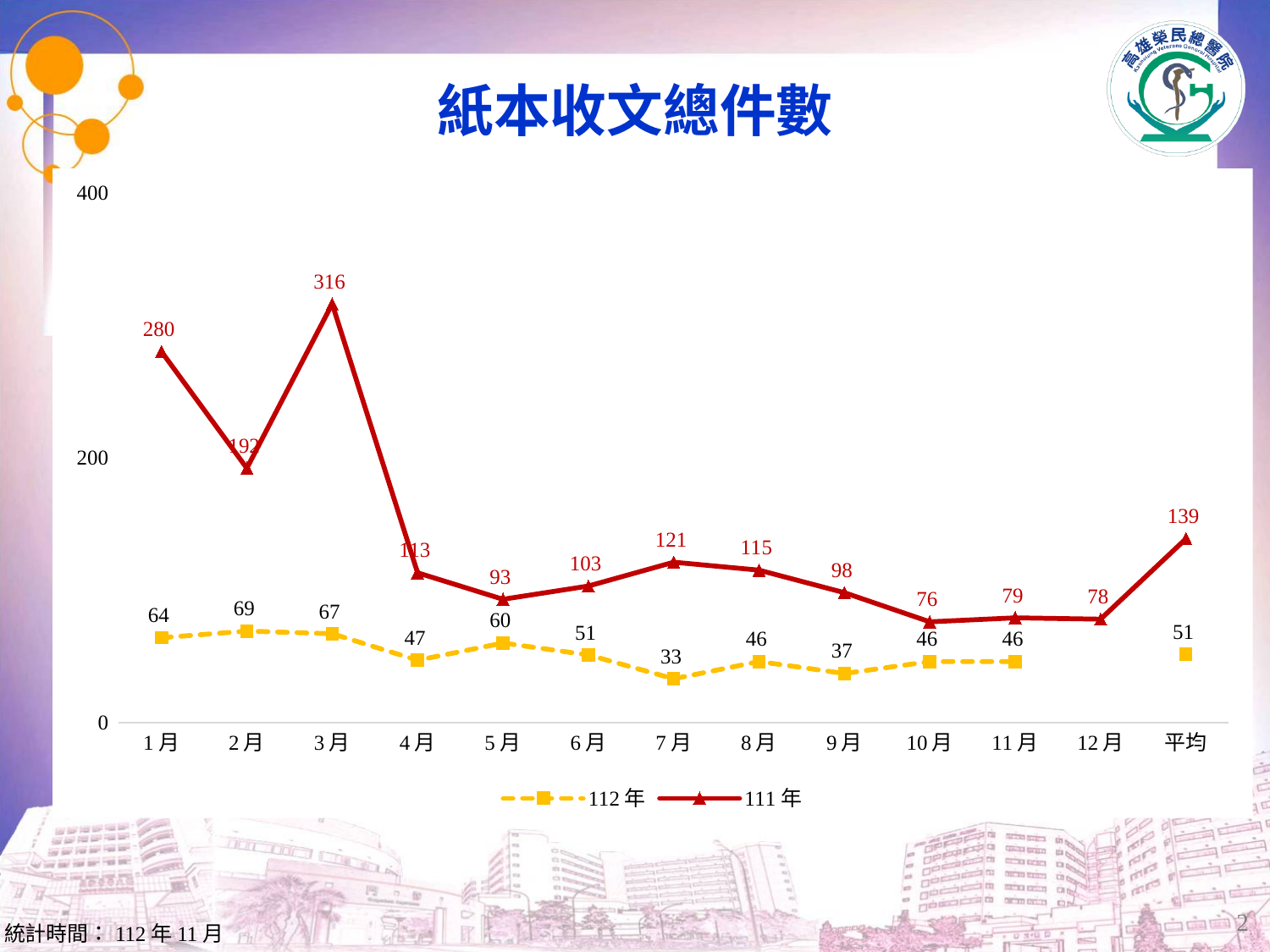
How many series does the legend list? 2 What type of chart is shown on the slide? line chart Which series has the larger value in 8月, 111年 or 112年? 111年 How many categories are shown on the x axis? 13 What is the 平均 value for 111年? 139 What is the value for 112年 in 7月? 33 Is the value for 111年 in 1月 greater or less than 200? greater In which month is the 111年 value highest? 3月 What is the value for 111年 in 3月? 316 In which month is the 112年 value lowest? 7月 What is the difference between the 111年 and 112年 values in 1月? 216 What is the title of the chart? 紙本收文總件數